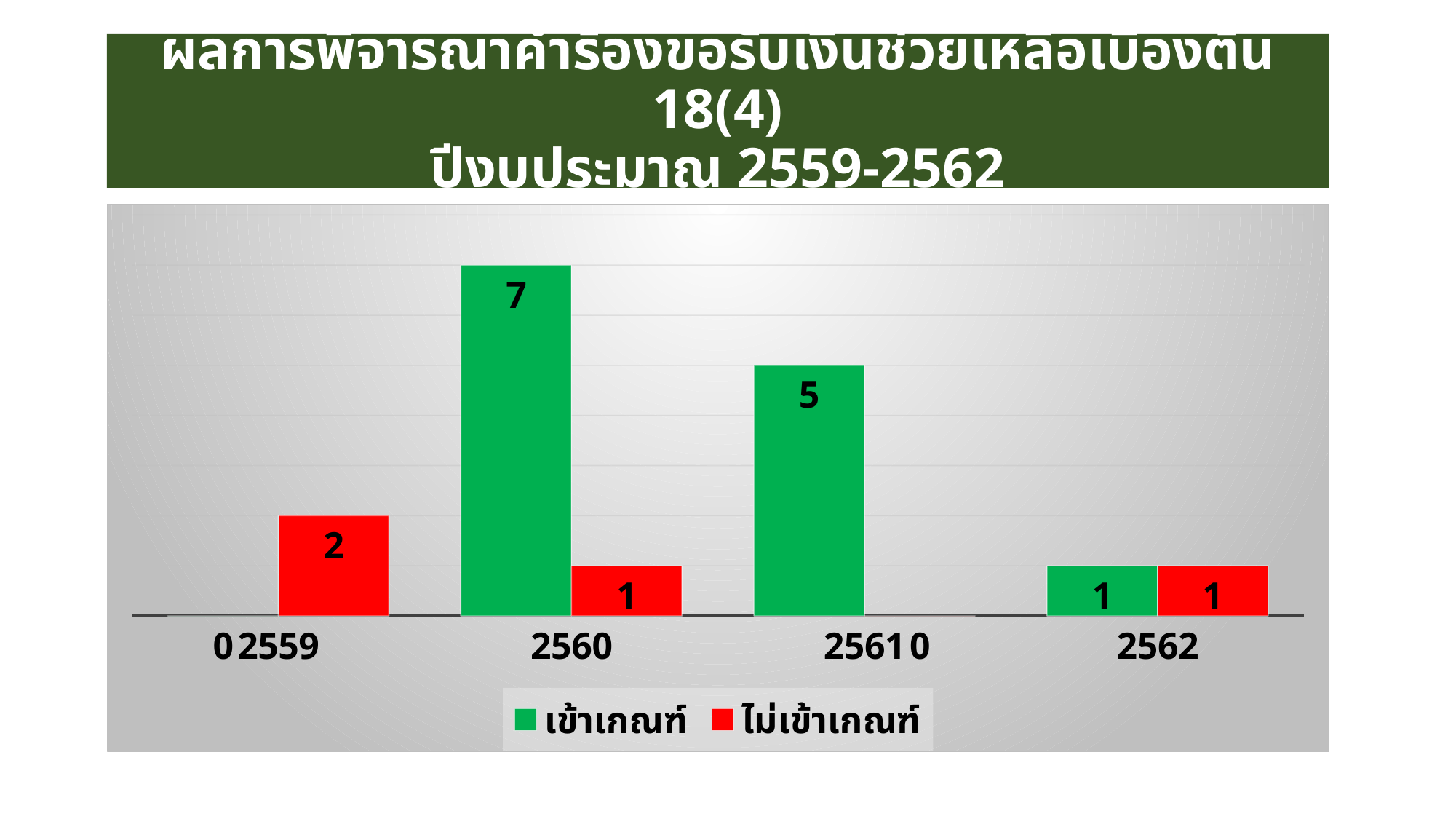
What is the value of เข้าเกณฑ์ for 2561? 5 In which year is the ไม่เข้าเกณฑ์ value highest? 2559 What is the difference between the เข้าเกณฑ์ values for 2560 and 2561? 2 How many series does the legend list? 2 What type of chart is shown on the slide? bar chart Which colour represents the เข้าเกณฑ์ series? green Which is larger for 2562, เข้าเกณฑ์ or ไม่เข้าเกณฑ์? They are equal (both 1) What is the value of เข้าเกณฑ์ for 2560? 7 What is the value of ไม่เข้าเกณฑ์ for 2559? 2 How many year categories are shown on the x axis? 4 In which year is the เข้าเกณฑ์ value highest? 2560 What is the value of ไม่เข้าเกณฑ์ for 2560? 1